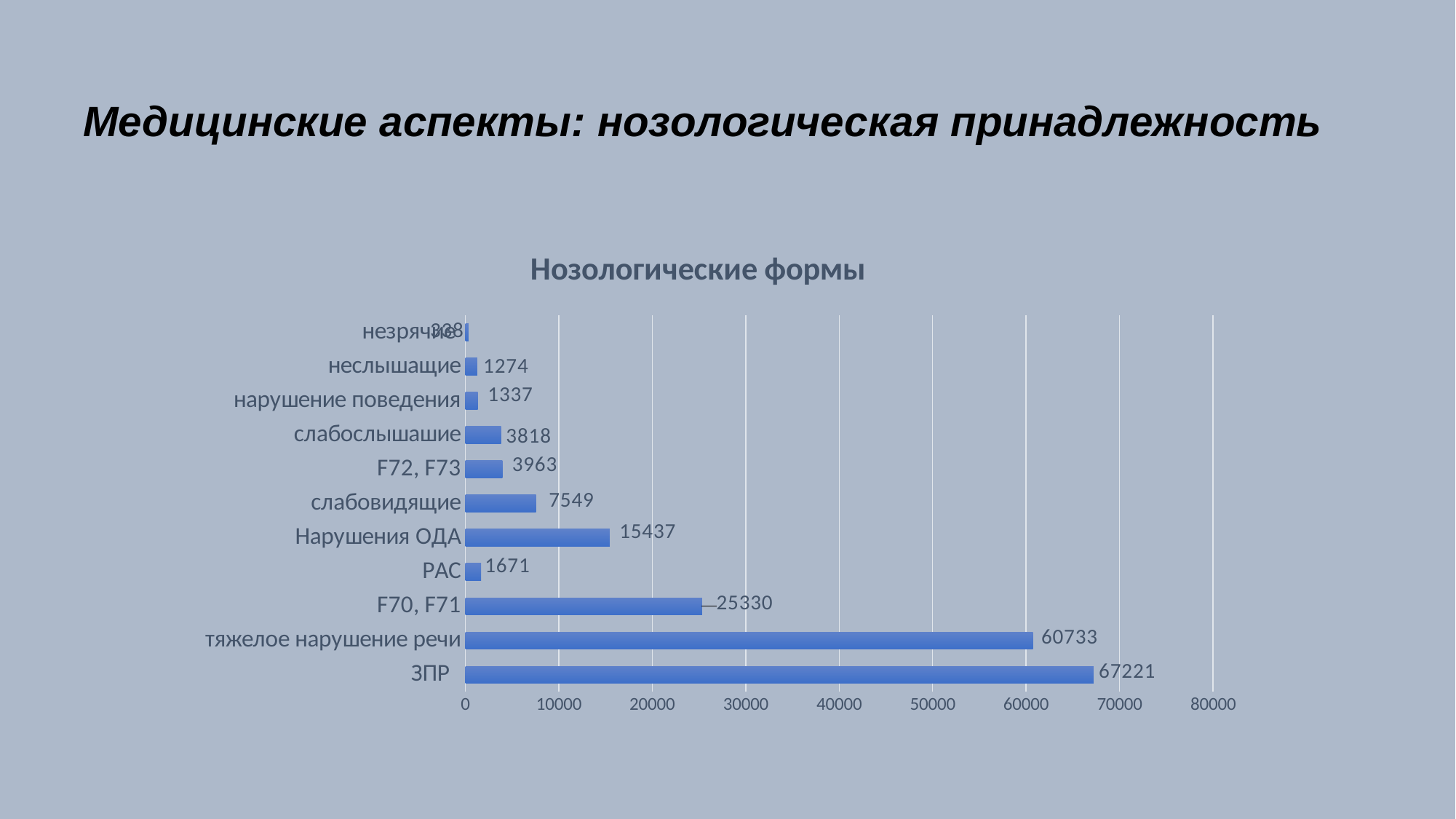
How many categories are shown in the chart? 11 What is the value for тяжелое нарушение речи? 60733 What is the title of the chart? Нозологические формы What is the value for ЗПР? 67221 What is the value for РАС? 1671 What is the difference between the values for ЗПР and тяжелое нарушение речи? 6488 Which category has the highest value? ЗПР Which category has the lowest value? незрячие What type of chart is shown on the slide? bar chart What is the value for Нарушения ОДА? 15437 Which is larger, the value for Нарушения ОДА or the value for слабовидящие? Нарушения ОДА Is the value for F70, F71 greater or less than 20000? greater